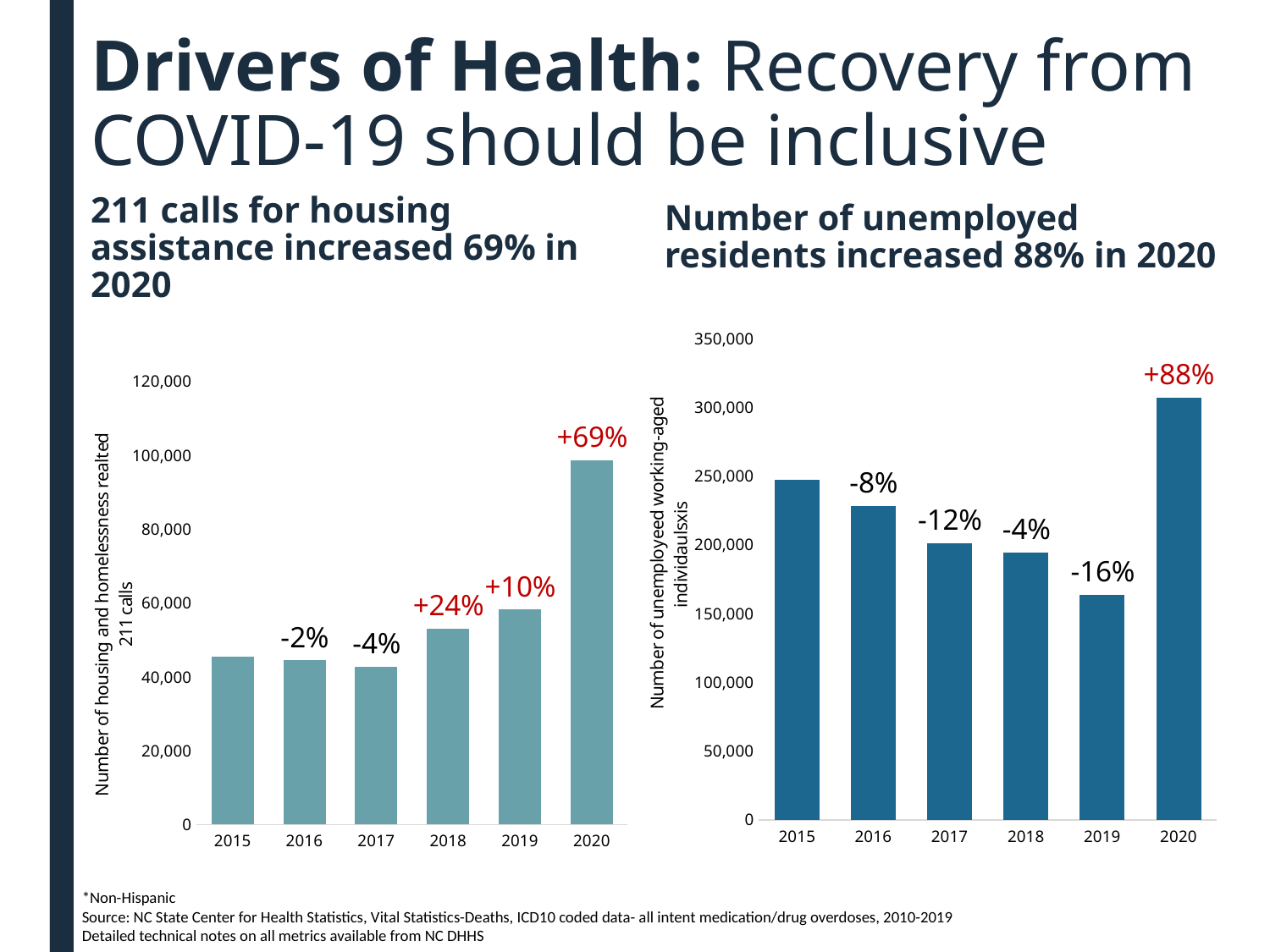
In the left chart (211 calls for housing assistance), which year has the highest bar? 2020 What kind of chart is the '211 calls for housing assistance' chart on the left? bar chart In the right chart (number of unemployed residents), which year has the lowest bar? 2019 In the left chart (211 calls for housing assistance), what percentage change label is shown above the 2020 bar? +69% In the right chart (number of unemployed residents), what percentage change label is shown above the 2017 bar? -12% In the right chart (number of unemployed residents), is the value for 2019 greater or less than 200,000? less How many years are shown on the x axis of the right chart (number of unemployed residents)? 6 In the right chart (number of unemployed residents), do the values rise or fall from 2015 to 2019? fall In the left chart (211 calls for housing assistance), what percentage change label is shown above the 2018 bar? +24% What is the y-axis label of the left chart? Number of housing and homelessness realted 211 calls In the left chart (211 calls for housing assistance), which is larger, the value for 2018 or the value for 2019? 2019 In the left chart (211 calls for housing assistance), is the value for 2020 greater or less than 80,000? greater